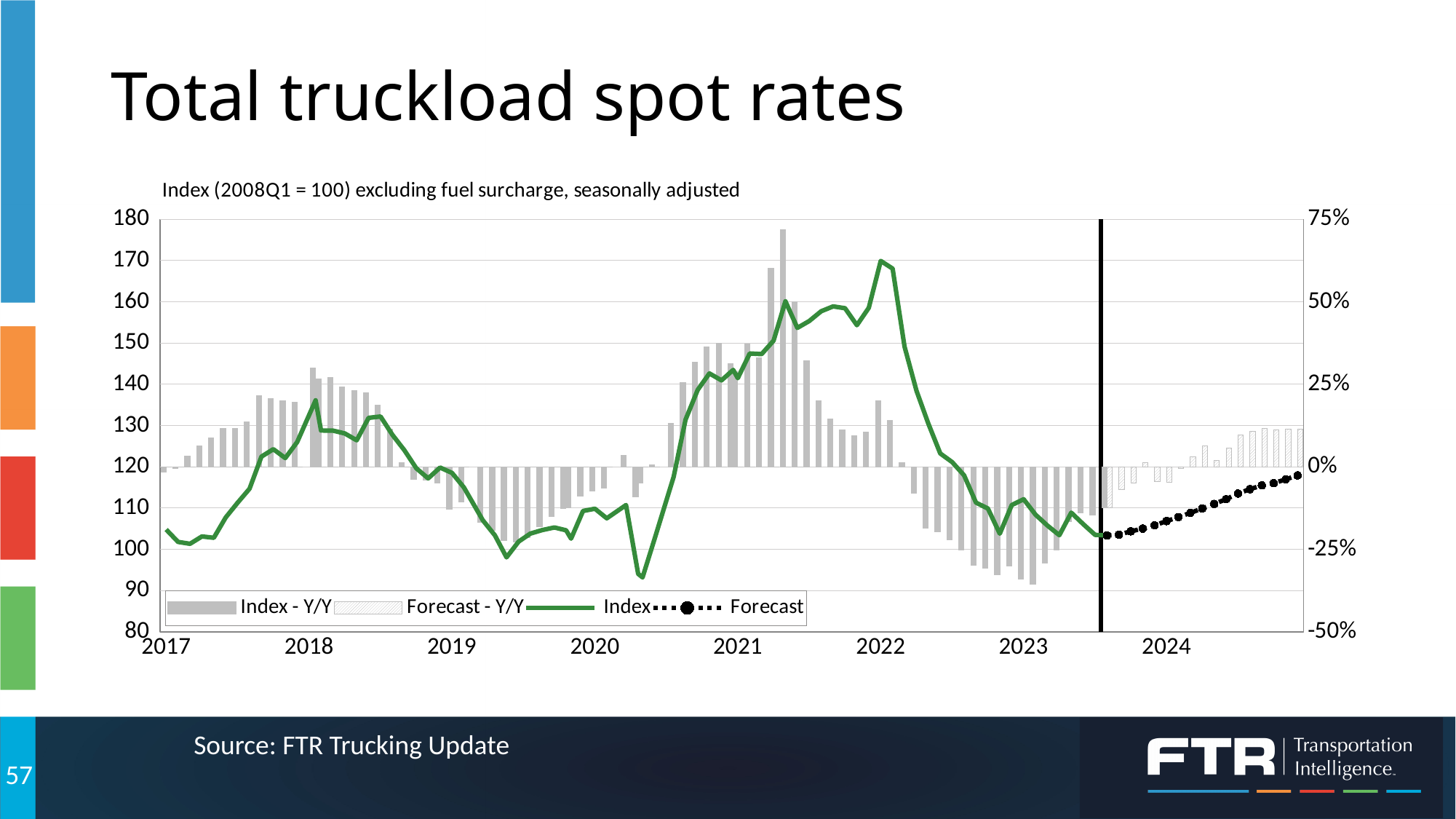
Is the peak of the Index line in early 2022 greater or less than 160? greater Is the lowest point of the Index line in 2020 greater or less than 100? less Does the Index line rise or fall from early 2022 through 2023? fall In which year does the Index line reach its highest point? 2022 What kind of chart is shown on the slide? A combined bar and line chart What source is cited for the chart? FTR Trucking Update Is the Index line at the start of 2017 greater or less than 110? less How many years are labeled on the x axis? 8 How many series does the legend list? 4 In which year does the Index line reach its lowest point? 2020 What is the title of the chart on the slide? Index (2008Q1 = 100) excluding fuel surcharge, seasonally adjusted Does the dotted Forecast line rise or fall across 2024? rise